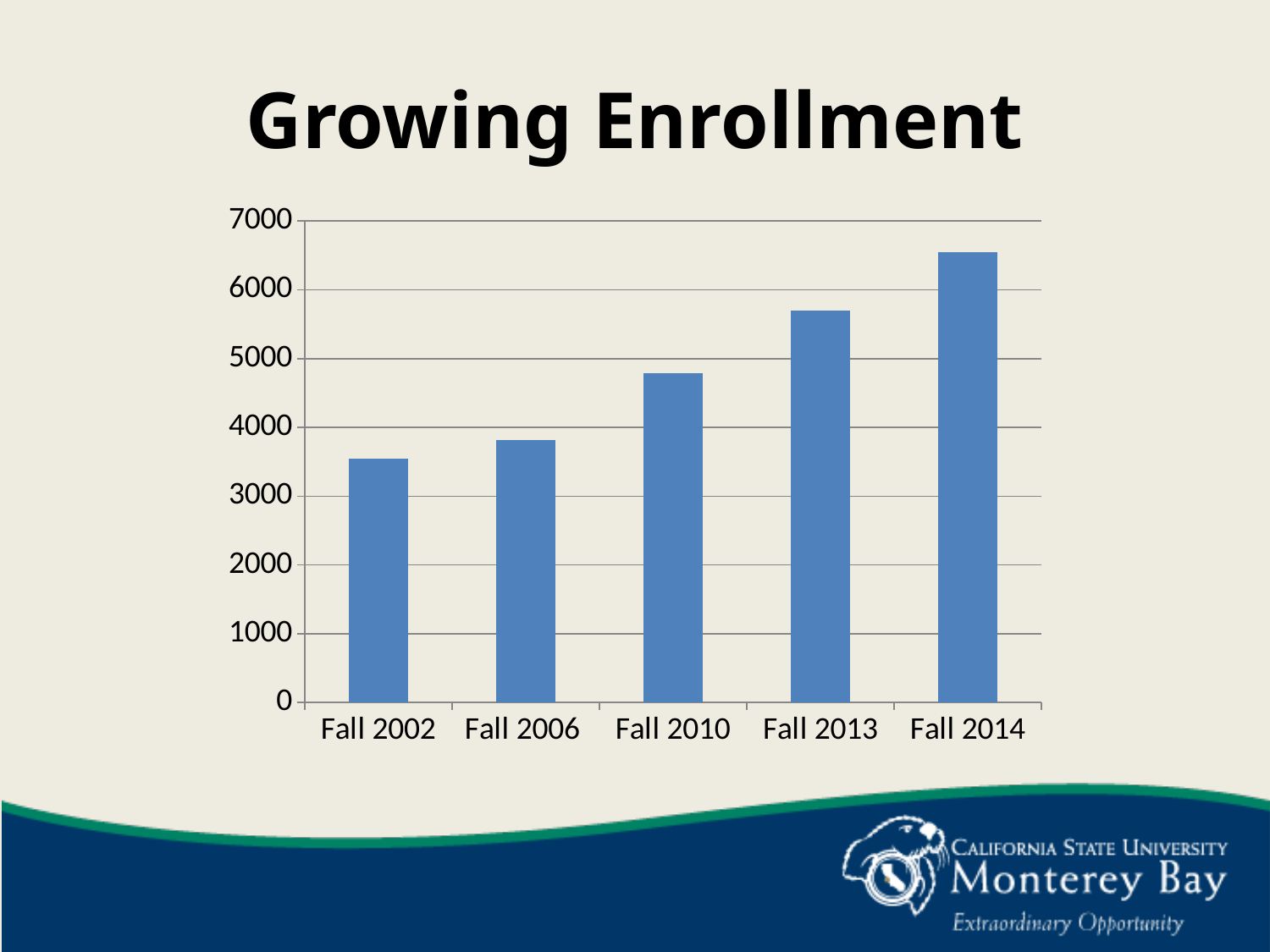
Which category has the highest value? Fall 2014 How many categories (bars) are shown in the chart? 5 What is the title of the slide's chart? Growing Enrollment Do the values rise or fall from Fall 2002 to Fall 2014? rise Which category has the lowest value? Fall 2002 Is the value for Fall 2010 greater or less than 5000? less What type of chart is shown on the slide? bar chart Is the value for Fall 2013 greater or less than 5000? greater Is the value for Fall 2002 greater or less than 4000? less Which is larger, the value for Fall 2010 or the value for Fall 2013? Fall 2013